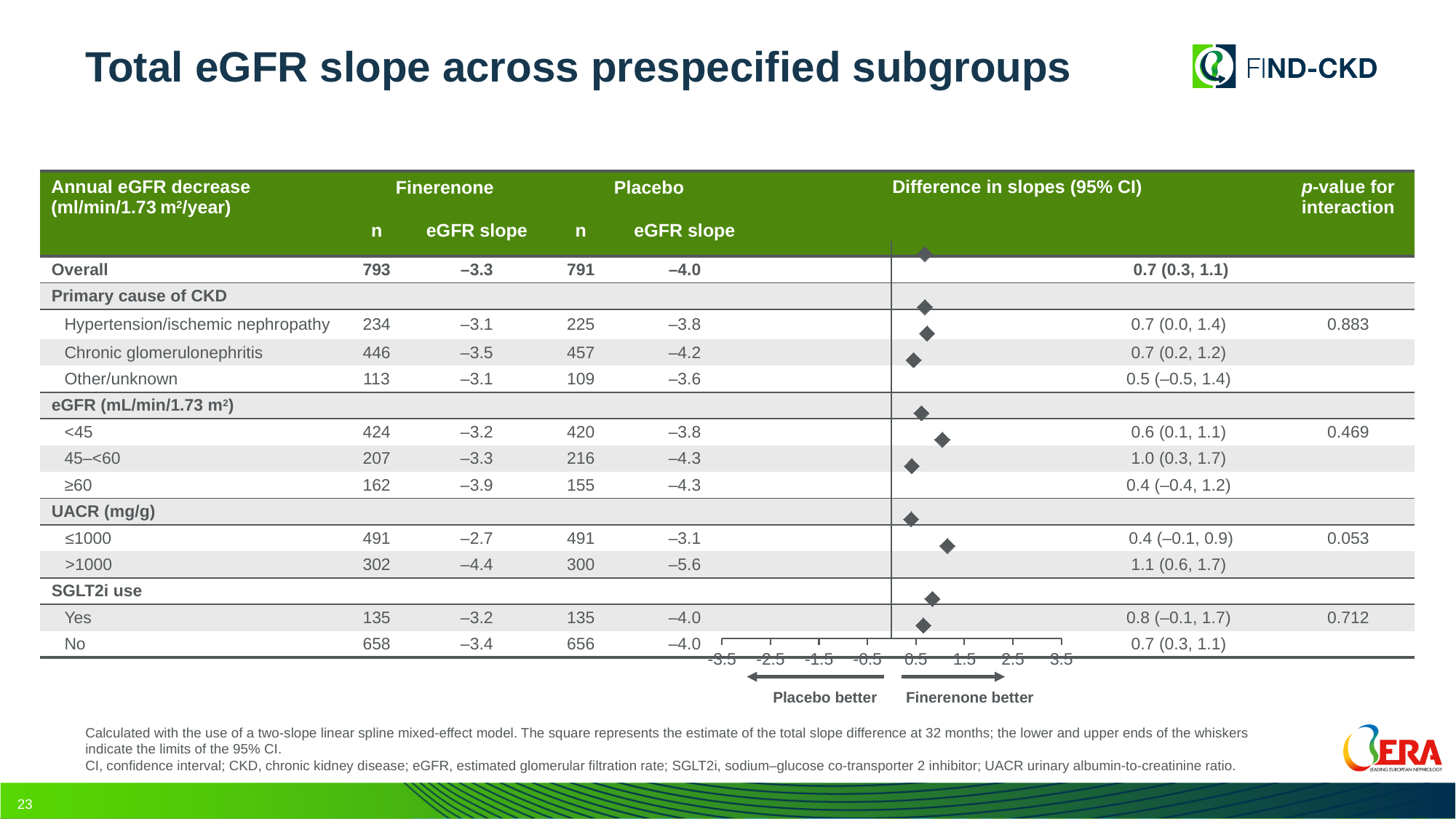
What is the difference in slopes (95% CI) for the UACR >1000 mg/g subgroup? 1.1 (0.6, 1.7) How many point estimates (diamonds) are plotted in the forest plot? 11 Which treatment is favoured by points to the right of the vertical line in the forest plot? Finerenone better What is the difference in slopes (95% CI) for the Other/unknown primary cause of CKD subgroup? 0.5 (–0.5, 1.4) Is the point estimate for the difference in slopes in the Overall group greater or less than 0.5? greater Which subgroup has the largest point estimate for the difference in slopes? >1000 (UACR) What kind of chart is shown in the Difference in slopes column? Forest plot What is the difference in slopes (95% CI) for the Overall group? 0.7 (0.3, 1.1) Which has a larger difference in slopes: the eGFR 45–<60 subgroup or the eGFR <45 subgroup? 45–<60 Within the eGFR subgroups, which has the smallest point estimate for the difference in slopes? ≥60 What are the minimum and maximum values shown on the x axis of the forest plot? -3.5 and 3.5 What is the difference between the point estimates for the UACR >1000 and UACR ≤1000 subgroups? 0.7